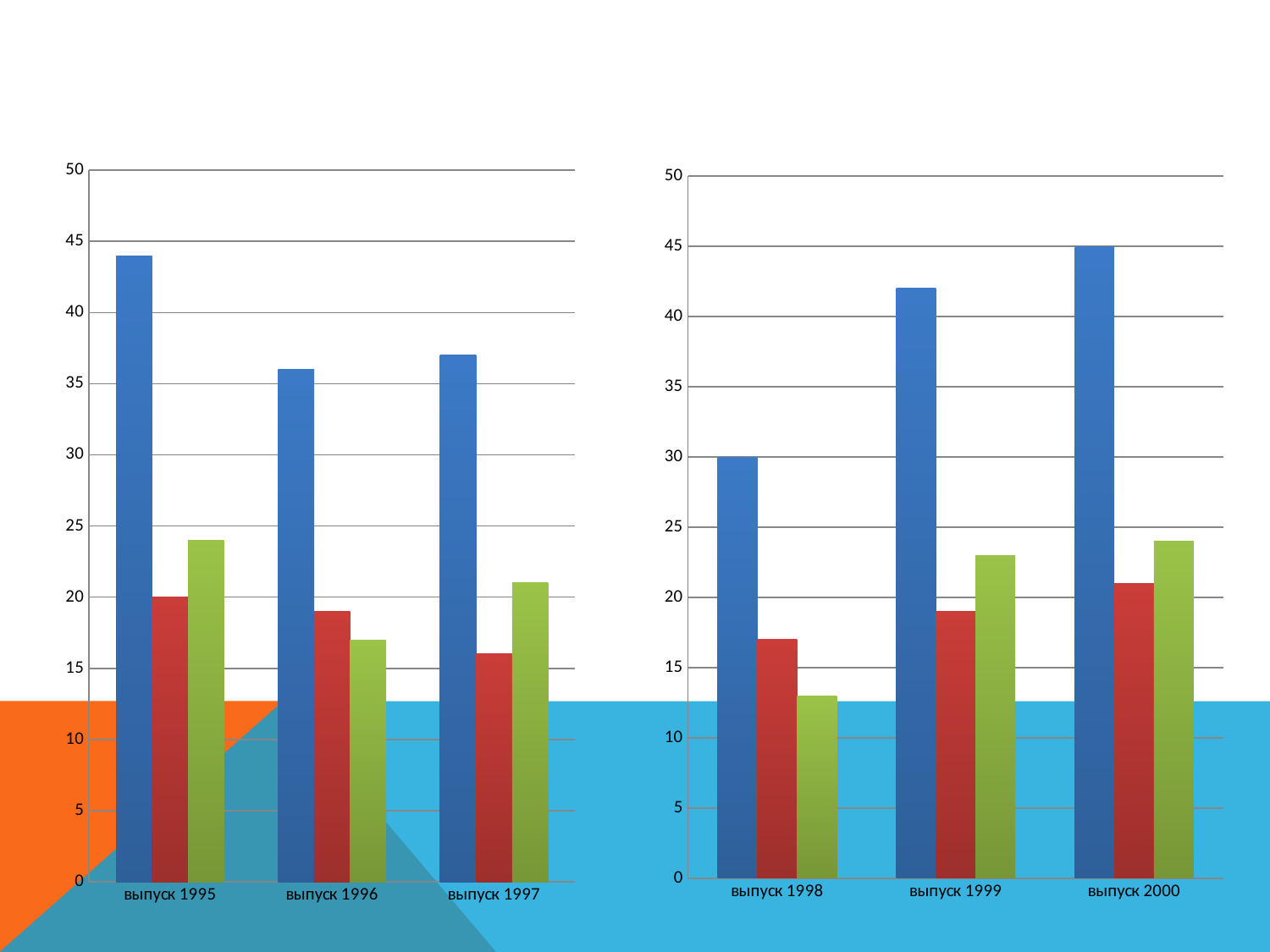
In the right chart, which category has the shortest green bar? выпуск 1998 How many bars are shown for each category in the left chart? 3 What kind of chart is the left chart on the slide? bar chart How many categories are shown on the x axis of the right chart? 3 In the left chart, is the blue bar for выпуск 1995 greater or less than 40? greater In the left chart, what is the value of the red bar for выпуск 1995? 20 In the left chart, which category has the tallest blue bar? выпуск 1995 In the right chart, do the blue bars rise or fall from выпуск 1998 to выпуск 2000? rise In the left chart, which is larger for выпуск 1996: the red bar or the green bar? the red bar In the right chart, what is the value of the blue bar for выпуск 1998? 30 In the right chart, is the green bar for выпуск 1998 greater or less than 15? less In the right chart, what is the value of the blue bar for выпуск 2000? 45